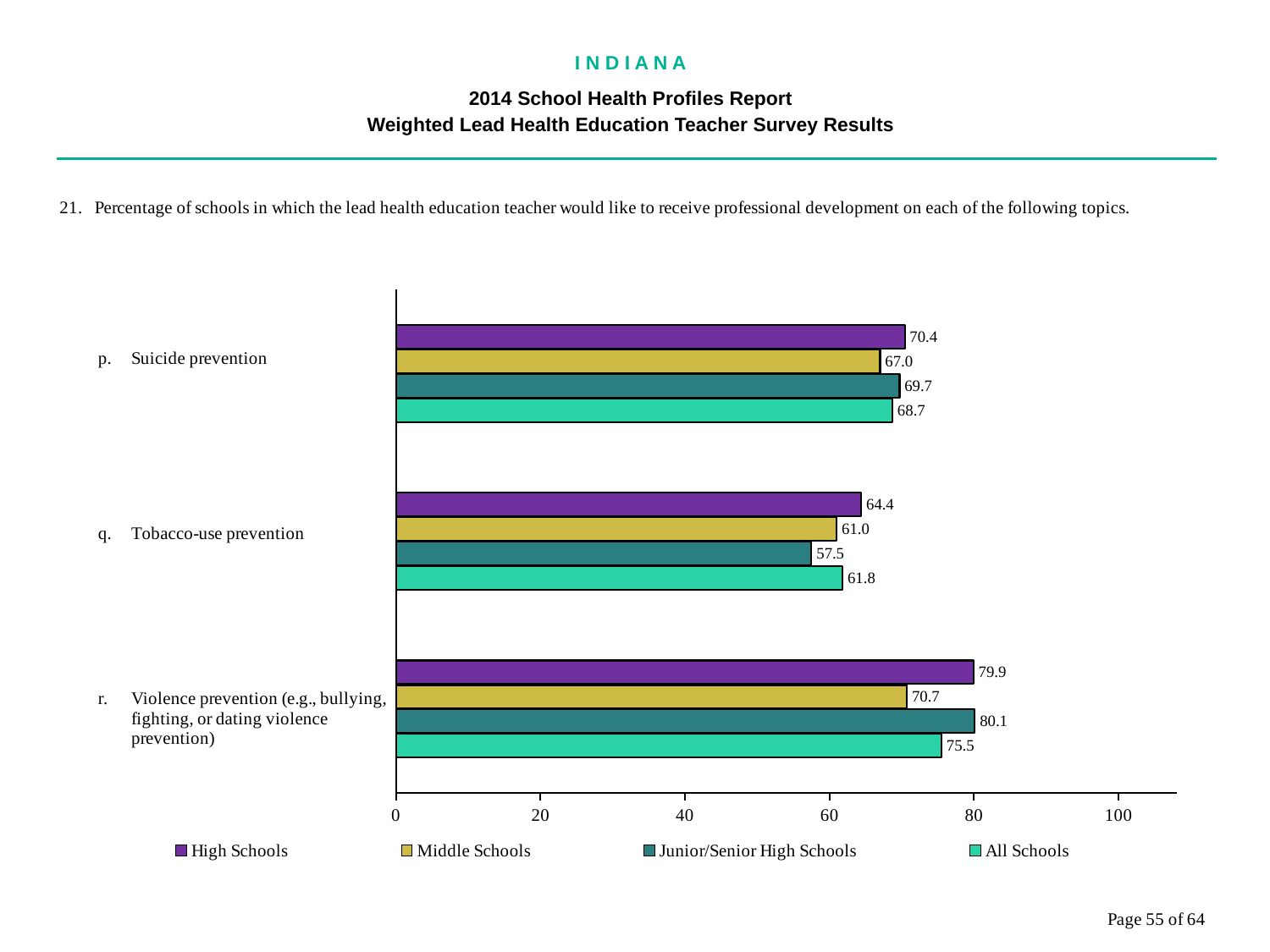
What is the value for Middle Schools for Tobacco-use prevention? 61.0 What is the value for High Schools for Suicide prevention? 70.4 What is the value for Junior/Senior High Schools for Violence prevention? 80.1 What kind of chart is shown on the slide? Bar chart Which topic has the highest value for High Schools? Violence prevention Is the value for All Schools for Violence prevention greater or less than 80? less How many series does the legend list? 4 What is the difference between the High Schools and Middle Schools values for Violence prevention? 9.2 How many topics are shown on the chart? 3 Which school type has the lowest value for Tobacco-use prevention? Junior/Senior High Schools What is the value for All Schools for Tobacco-use prevention? 61.8 Which is larger for Suicide prevention: the Junior/Senior High Schools value or the Middle Schools value? Junior/Senior High Schools